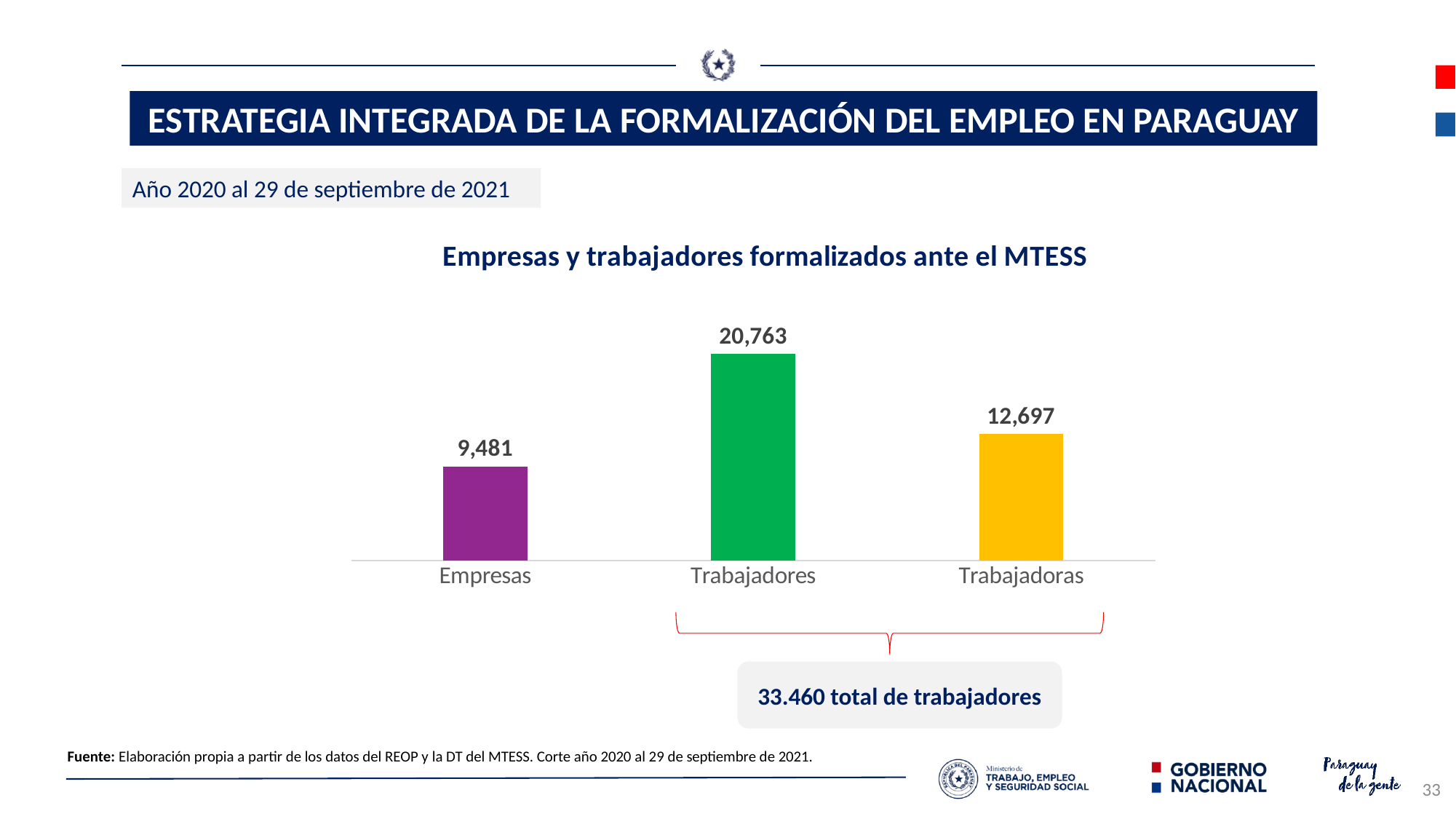
What colour is the bar for Trabajadores? Green What is the value for Empresas? 9,481 What is the title of the chart? Empresas y trabajadores formalizados ante el MTESS What is the difference between the values for Trabajadores and Trabajadoras? 8,066 What is the difference between the values for Trabajadoras and Empresas? 3,216 Which category has the lowest value? Empresas What is the value for Trabajadores? 20,763 What is the value for Trabajadoras? 12,697 How many categories are shown in the chart? 3 Which is larger, the value for Empresas or the value for Trabajadoras? Trabajadoras Which category has the highest value? Trabajadores What kind of chart is shown on the slide? Bar chart